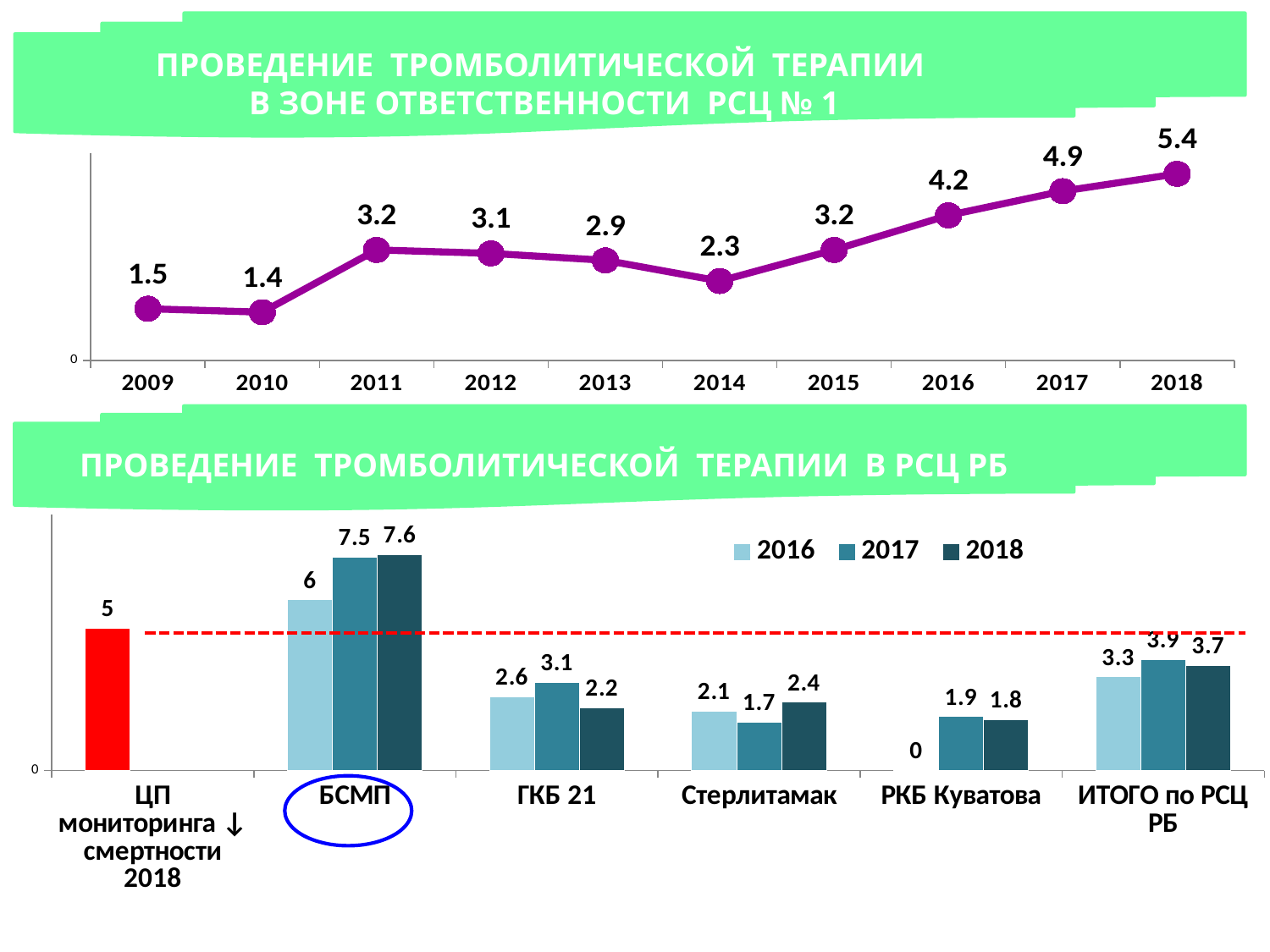
What kind of chart is the bottom chart? bar chart In the top chart, do the values rise or fall from 2014 to 2018? rise In the bottom chart, which is larger for Стерлитамак: the 2017 value or the 2018 value? 2018 In the top chart, which year has the highest value? 2018 In the bottom chart (ПРОВЕДЕНИЕ ТРОМБОЛИТИЧЕСКОЙ ТЕРАПИИ В РСЦ РБ), what is the value for БСМП in 2018? 7.6 In the bottom chart, how many series does the legend list? 3 In the top chart (ПРОВЕДЕНИЕ ТРОМБОЛИТИЧЕСКОЙ ТЕРАПИИ В ЗОНЕ ОТВЕТСТВЕННОСТИ РСЦ № 1), what is the value for 2014? 2.3 In the top chart, how many years are plotted on the x axis? 10 In the bottom chart, what is the difference between the 2017 and 2016 values for ИТОГО по РСЦ РБ? 0.6 In the top chart, which year has the lowest value? 2010 In the top chart, what is the difference between the values for 2018 and 2009? 3.9 What kind of chart is the top chart? line chart